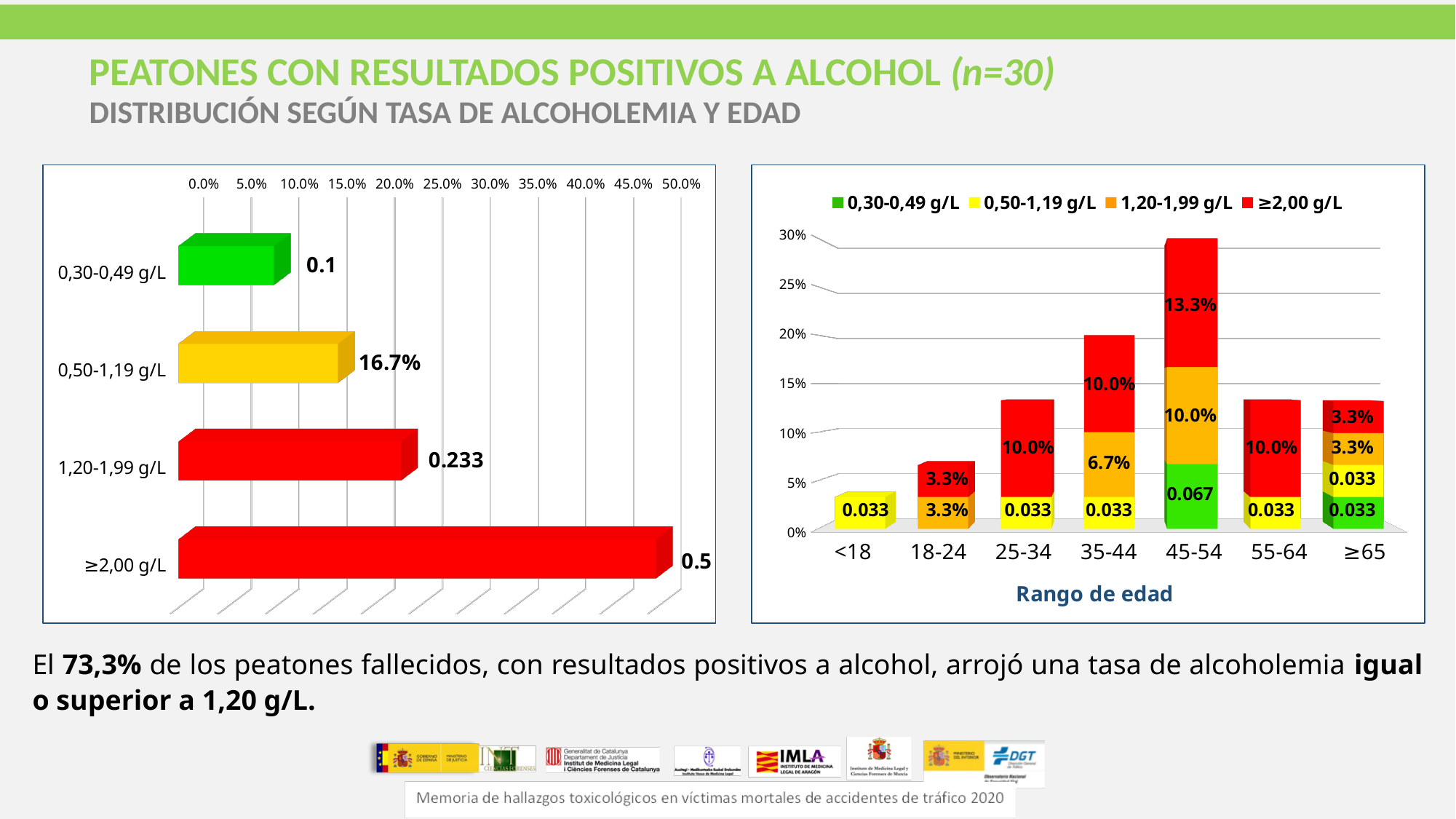
How many categories are shown in the left chart? 4 What is the x-axis title of the right chart? Rango de edad How many series does the legend of the right chart list? 4 In the right chart, what is the value of the ≥2,00 g/L segment for the 45-54 age range? 13.3% In the right chart, what is the value of the 1,20-1,99 g/L segment for the 35-44 age range? 6.7% In the left chart, which category has the shortest bar? 0,30-0,49 g/L In the left chart, what is the value shown for the ≥2,00 g/L category? 0.5 In the left chart, which category has the longest bar? ≥2,00 g/L In the right chart, which age range has the tallest stacked bar? 45-54 What kind of chart is the left chart? Bar chart In the left chart, what is the value shown for the 0,50-1,19 g/L category? 16.7% How many age ranges are shown on the x axis of the right chart? 7